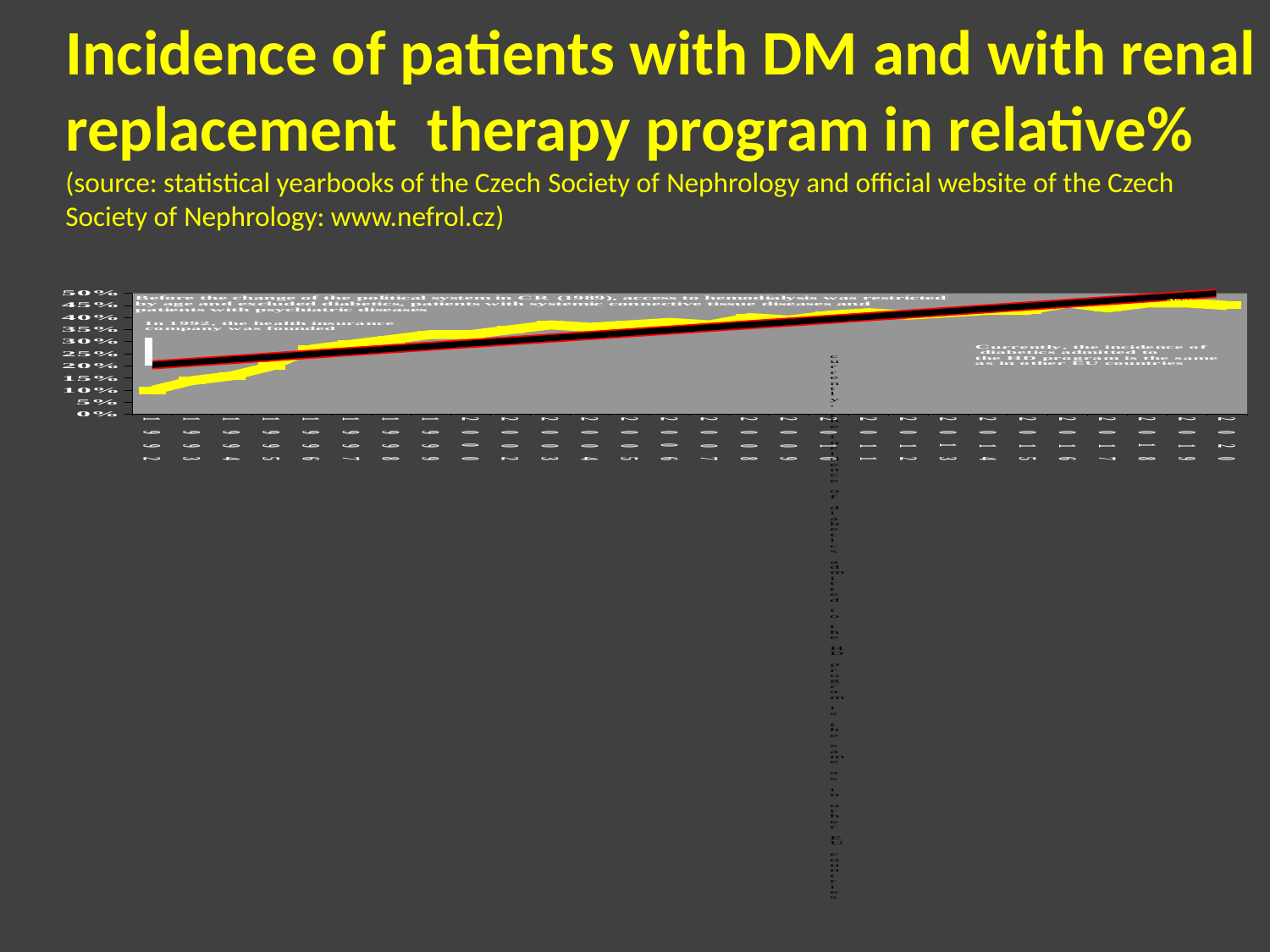
Is the value for 2020 greater or less than 35%? greater Is the value for 1992 greater or less than 20%? less What is the highest value shown on the y axis? 50% What is the first year shown on the x axis? 1992 Which is larger, the value for 1992 or the value for 2020? 2020 What kind of chart is shown on the slide? line chart Is the value for 2005 greater or less than 20%? greater Which year has the lowest value on the chart? 1992 How many years are plotted on the x axis? 28 Do the values rise or fall from 1992 to 2020? rise